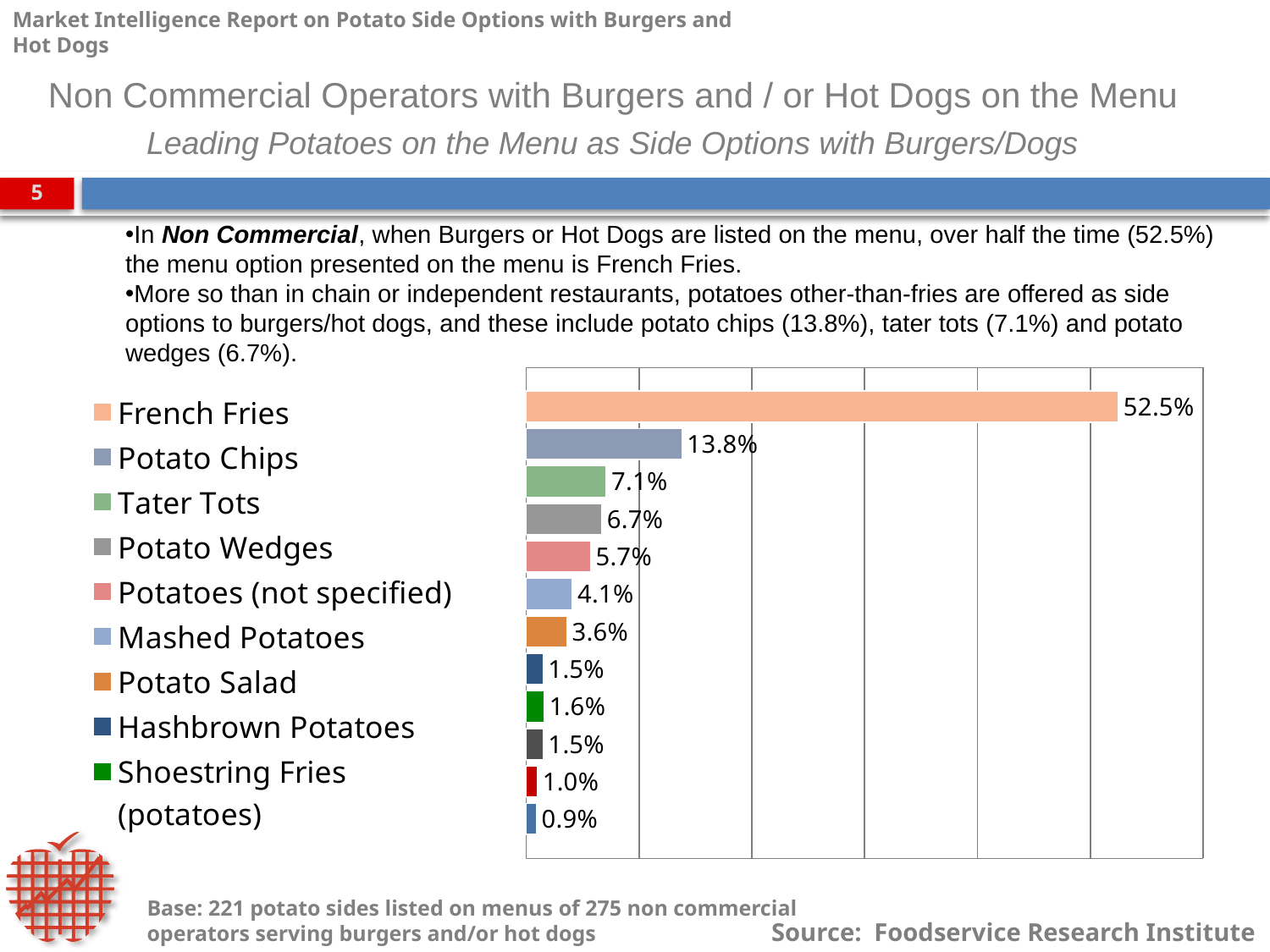
What is the value for Potato Wedges? 6.7% What is the value for Potato Salad? 3.6% Which is larger, the value for Potato Chips or the value for Tater Tots? Potato Chips What is the value for French Fries? 52.5% What is the difference between the values for French Fries and Potato Chips? 38.7% How many entries does the legend list? 9 What is the value for Potato Chips? 13.8% How many bars are plotted on the chart? 12 What is the value for Tater Tots? 7.1% What kind of chart is shown on the slide? bar chart What is the value for Mashed Potatoes? 4.1% Which category has the highest value? French Fries